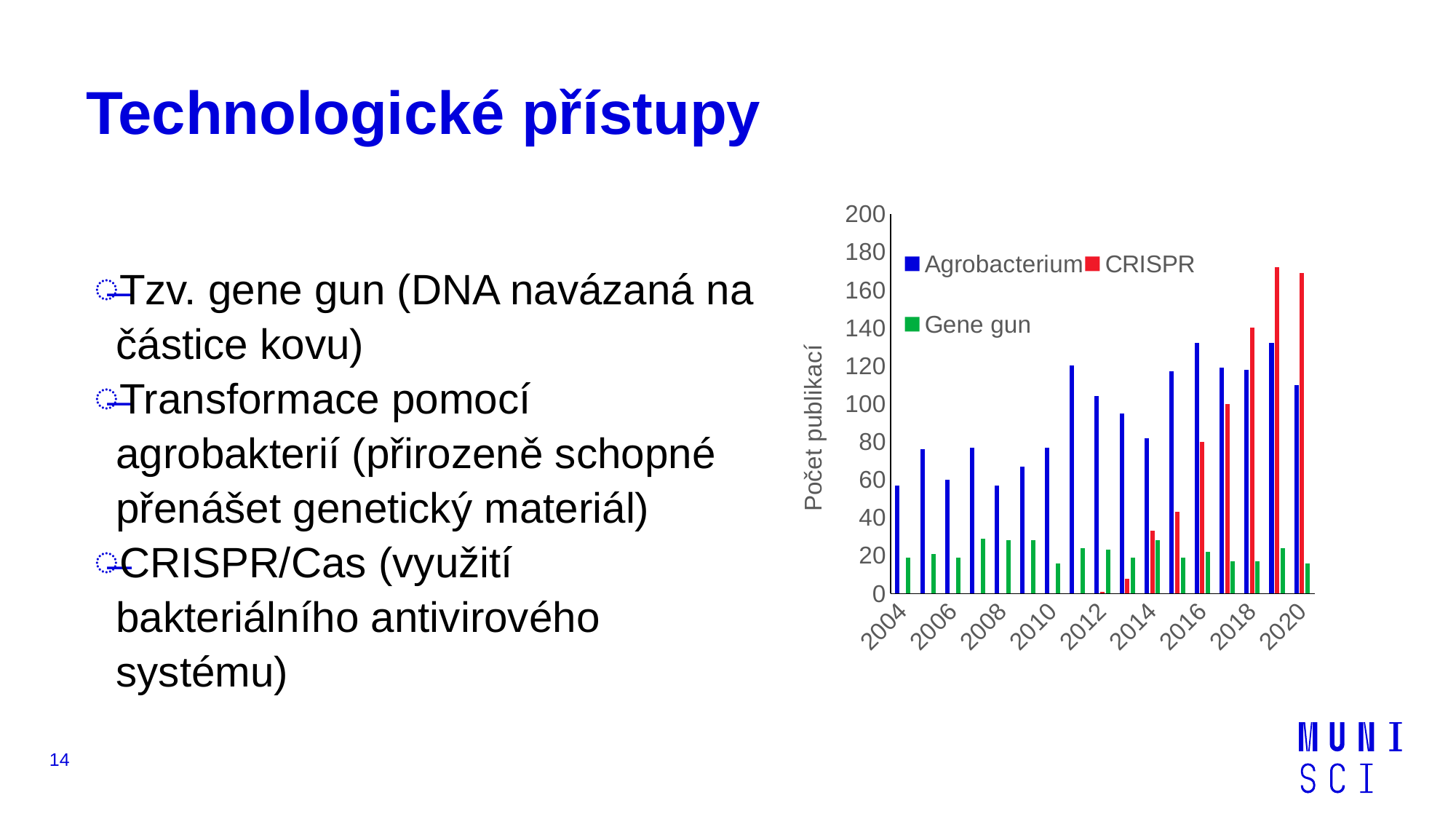
Is the CRISPR value for 2019 greater or less than 160? greater How many series does the chart's legend list? 3 Which colour represents the Gene gun series in the chart? green In 2020, which series has the larger value, Agrobacterium or CRISPR? CRISPR In 2014, which series has the larger value, Agrobacterium or CRISPR? Agrobacterium What is the label of the vertical axis of the chart? Počet publikací Do the CRISPR values generally rise or fall from 2013 to 2020? rise Is the Agrobacterium value for 2011 greater or less than 100? greater Is the Gene gun value for 2008 greater or less than 20? greater In 2016, which series has the larger value, Agrobacterium or CRISPR? Agrobacterium What kind of chart is shown on the slide? bar chart